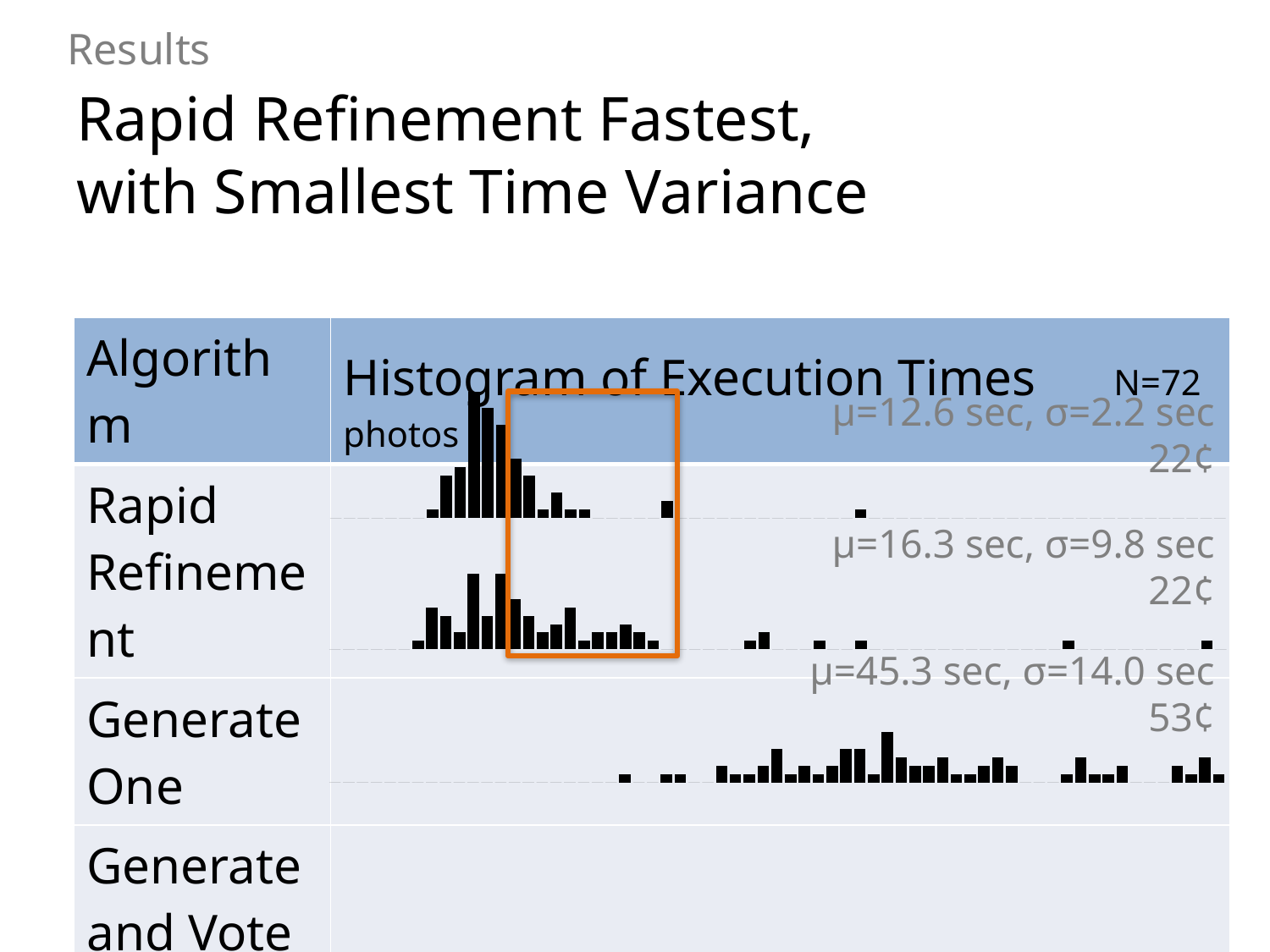
Which algorithm has the highest mean execution time? Generate and Vote What is the title of the chart on the slide? Histogram of Execution Times What cost is shown next to the Generate and Vote histogram? 53¢ Which has a larger standard deviation of execution time, Generate One or Generate and Vote? Generate and Vote How many histograms of execution times are shown on the slide? 3 What is the mean execution time shown for the Rapid Refinement histogram? 12.6 sec What is the difference between the mean execution times of Generate and Vote and Rapid Refinement? 32.7 sec Which algorithm has the smallest standard deviation of execution time? Rapid Refinement How many photos (N) were used for the histograms of execution times? 72 What is the mean execution time shown for the Generate One histogram? 16.3 sec What is the standard deviation of execution time shown for the Rapid Refinement histogram? 2.2 sec What is the standard deviation of execution time shown for the Generate and Vote histogram? 14.0 sec